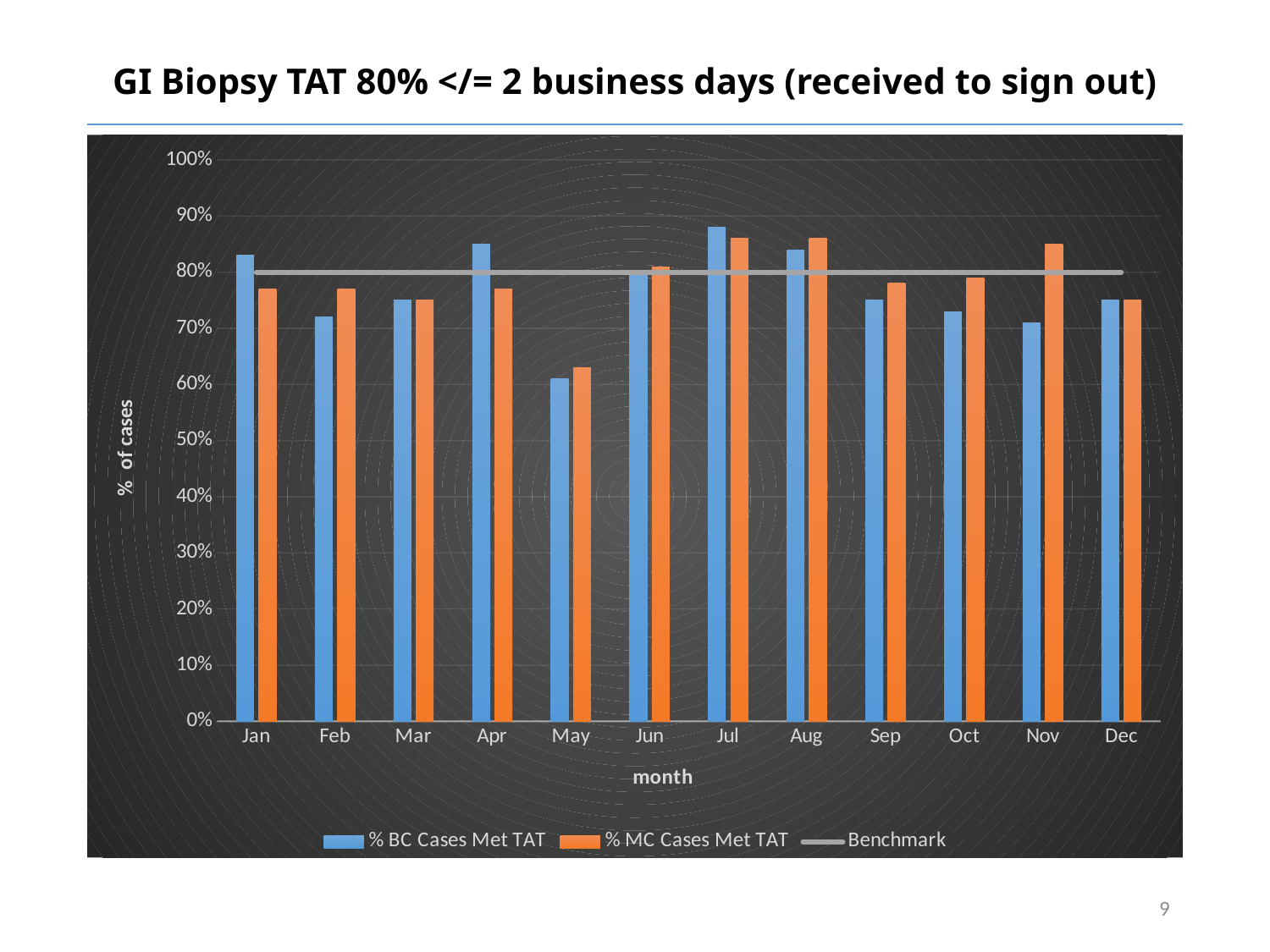
How many series does the legend list? 3 How many months are shown on the x axis? 12 What kind of chart is shown on the slide? bar and line chart At what value does the Benchmark line sit? 80% Which month has the lowest value for % MC Cases Met TAT? May Is the value for % BC Cases Met TAT in Nov greater or less than 80%? less Which month has the highest value for % BC Cases Met TAT? Jul What is the label on the y axis? % of cases Is the value for % MC Cases Met TAT in Aug greater or less than 80%? greater Is the value for % BC Cases Met TAT in May greater or less than 70%? less Which month has the lowest value for % BC Cases Met TAT? May In Nov, which is larger: % BC Cases Met TAT or % MC Cases Met TAT? % MC Cases Met TAT